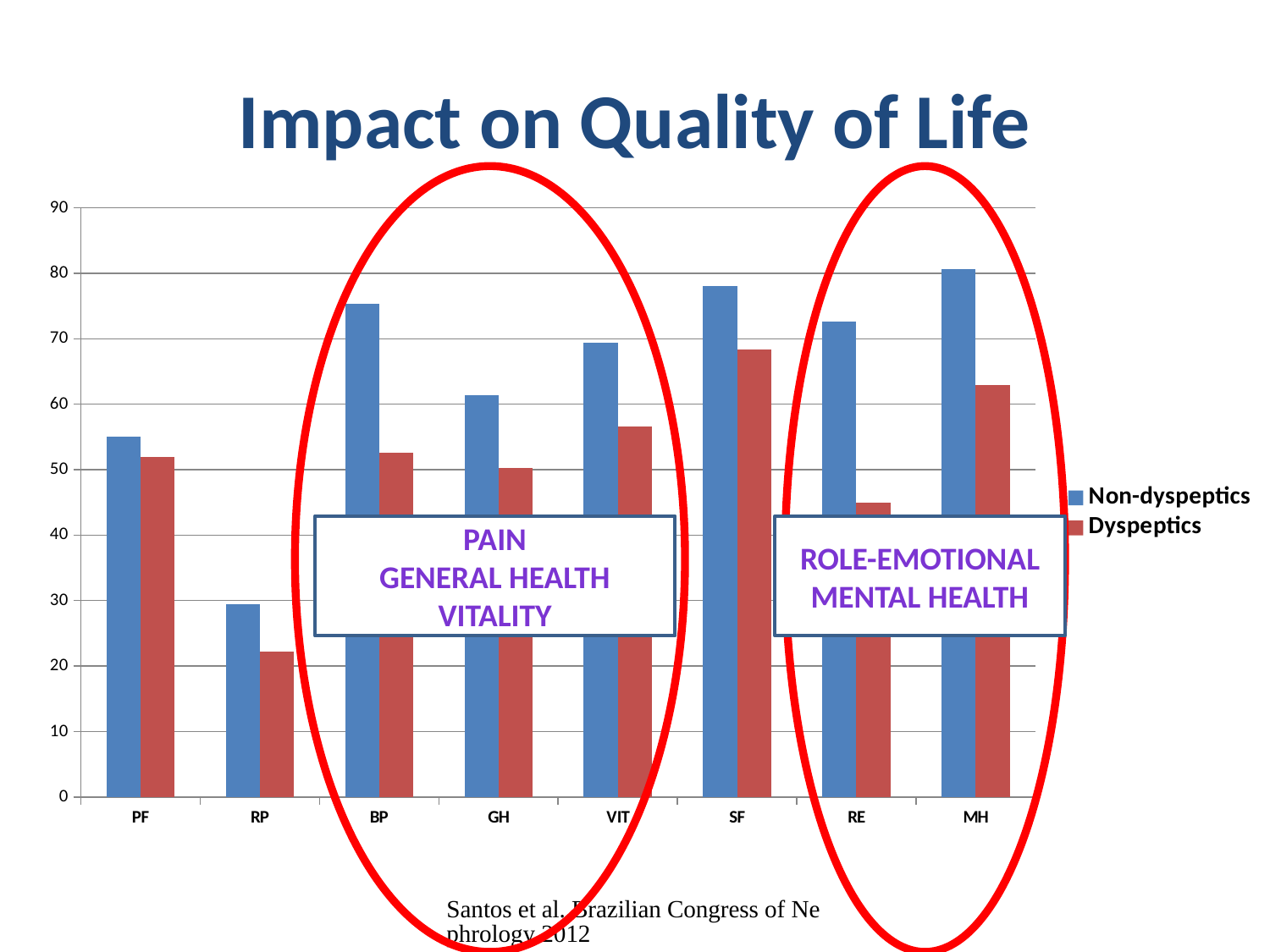
Which category has the highest value for Dyspeptics? SF Which colour represents the Dyspeptics series in the chart? red How many categories are shown along the x axis of the chart? 8 Is the Dyspeptics value for RE greater or less than 50? less How many series does the chart's legend list? 2 Which category has the lowest value for Non-dyspeptics? RP What kind of chart is shown on the slide? bar chart What is the title of the chart? Impact on Quality of Life For RE, which series has the larger value, Non-dyspeptics or Dyspeptics? Non-dyspeptics Which category has the lowest value for Dyspeptics? RP Is the Dyspeptics value for SF greater or less than 60? greater Is the Non-dyspeptics value for BP greater or less than 70? greater